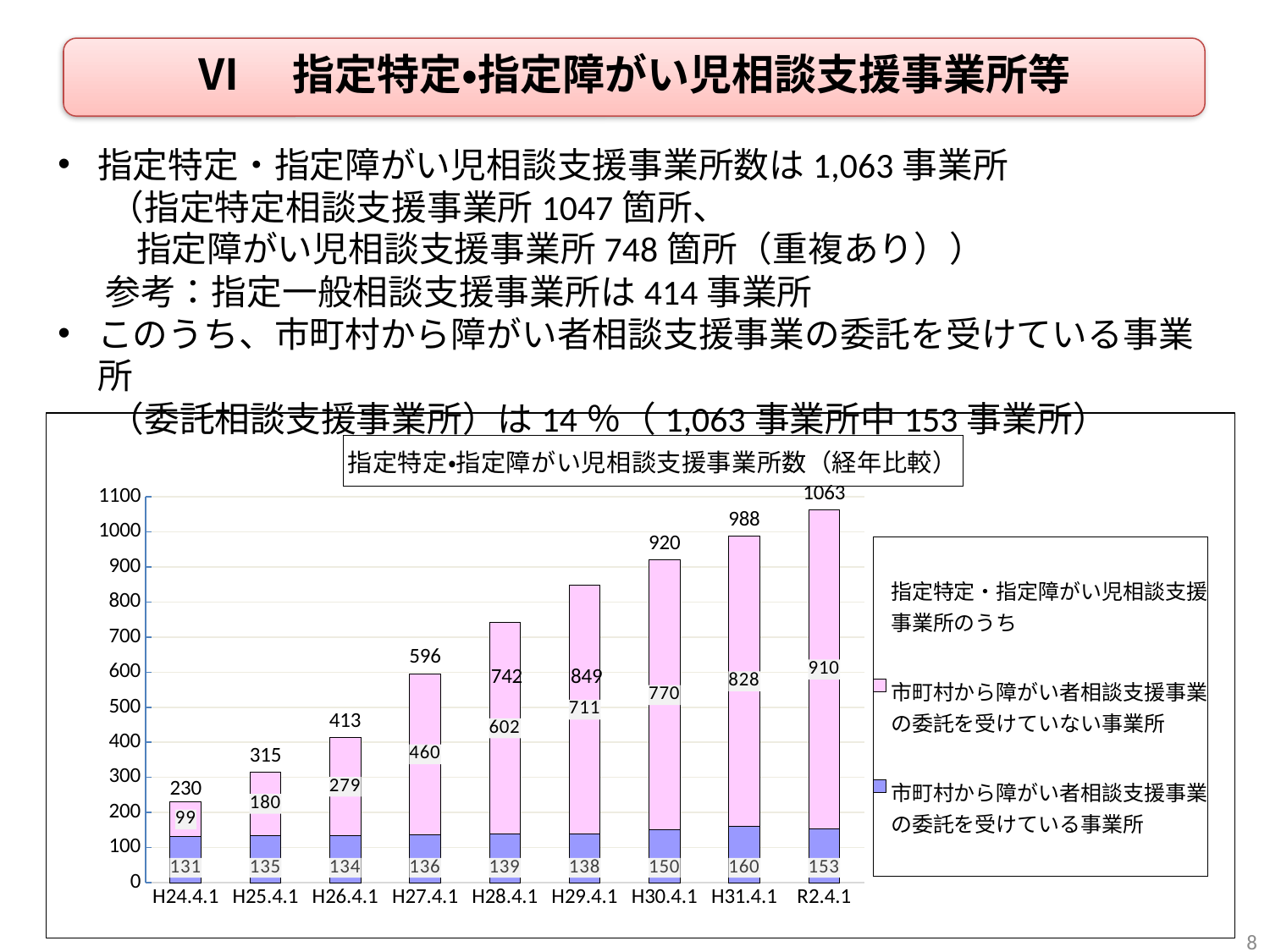
What is the value for 市町村から障がい者相談支援事業の委託を受けていない事業所 at H24.4.1? 99 At which time point is the value for 委託を受けている事業所 the highest? H31.4.1 Which is larger: the value for 委託を受けていない事業所 at H27.4.1 or at H28.4.1? H28.4.1 What is the total number of 指定特定・指定障がい児相談支援事業所 shown for R2.4.1? 1063 At which time point is the total number of 事業所 the lowest? H24.4.1 What is the difference between the total for R2.4.1 and the total for H31.4.1? 75 How many time points (categories) are shown on the x axis of the chart? 9 What is the title of the chart? 指定特定•指定障がい児相談支援事業所数（経年比較） What is the value for 市町村から障がい者相談支援事業の委託を受けている事業所 at H31.4.1? 160 What kind of chart is shown on the slide? stacked bar chart Do the total values rise or fall from H24.4.1 to R2.4.1? rise